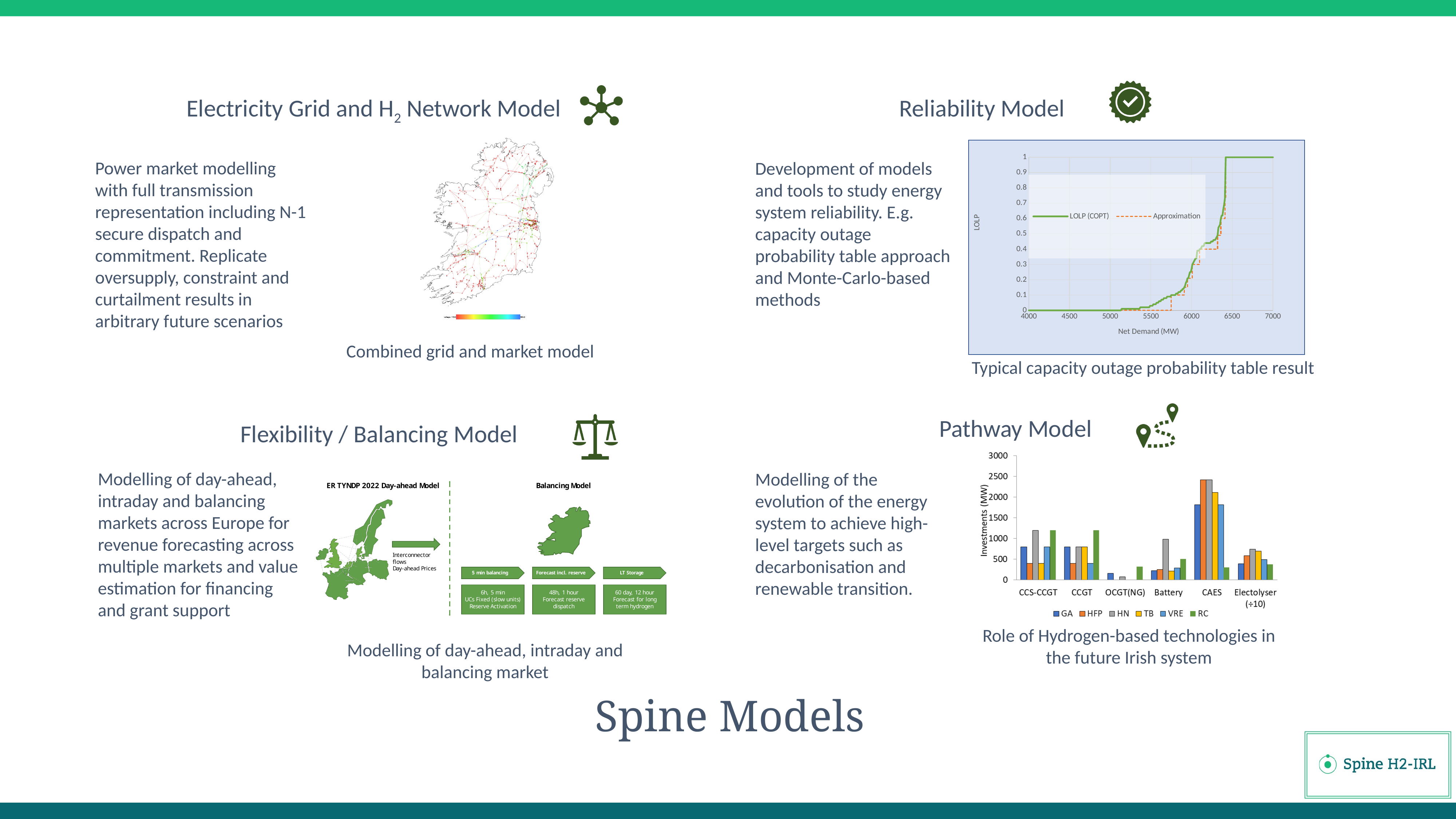
What kind of chart is shown under the Pathway Model heading? bar chart In the Reliability Model chart, is the LOLP (COPT) value at a Net Demand of 6000 MW greater or less than 0.5? less In the Pathway Model bar chart, which is larger for Battery: the HN value or the GA value? HN In the Reliability Model chart, does LOLP rise or fall as Net Demand increases along the x axis? rise In the Pathway Model bar chart, how many technology categories are shown on the x axis? 6 In the Pathway Model bar chart, which technology category has the tallest bars? CAES In the Reliability Model chart, how many series does the legend list? 2 In the Pathway Model bar chart, is the GA value for CAES greater or less than 1500? greater What is the y-axis label of the Pathway Model bar chart? Investments (MW) In the Reliability Model chart, is the LOLP (COPT) value at a Net Demand of 6500 MW greater or less than 0.5? greater In the Pathway Model bar chart, how many series does the legend list? 6 What kind of chart is shown under the Reliability Model heading? line chart